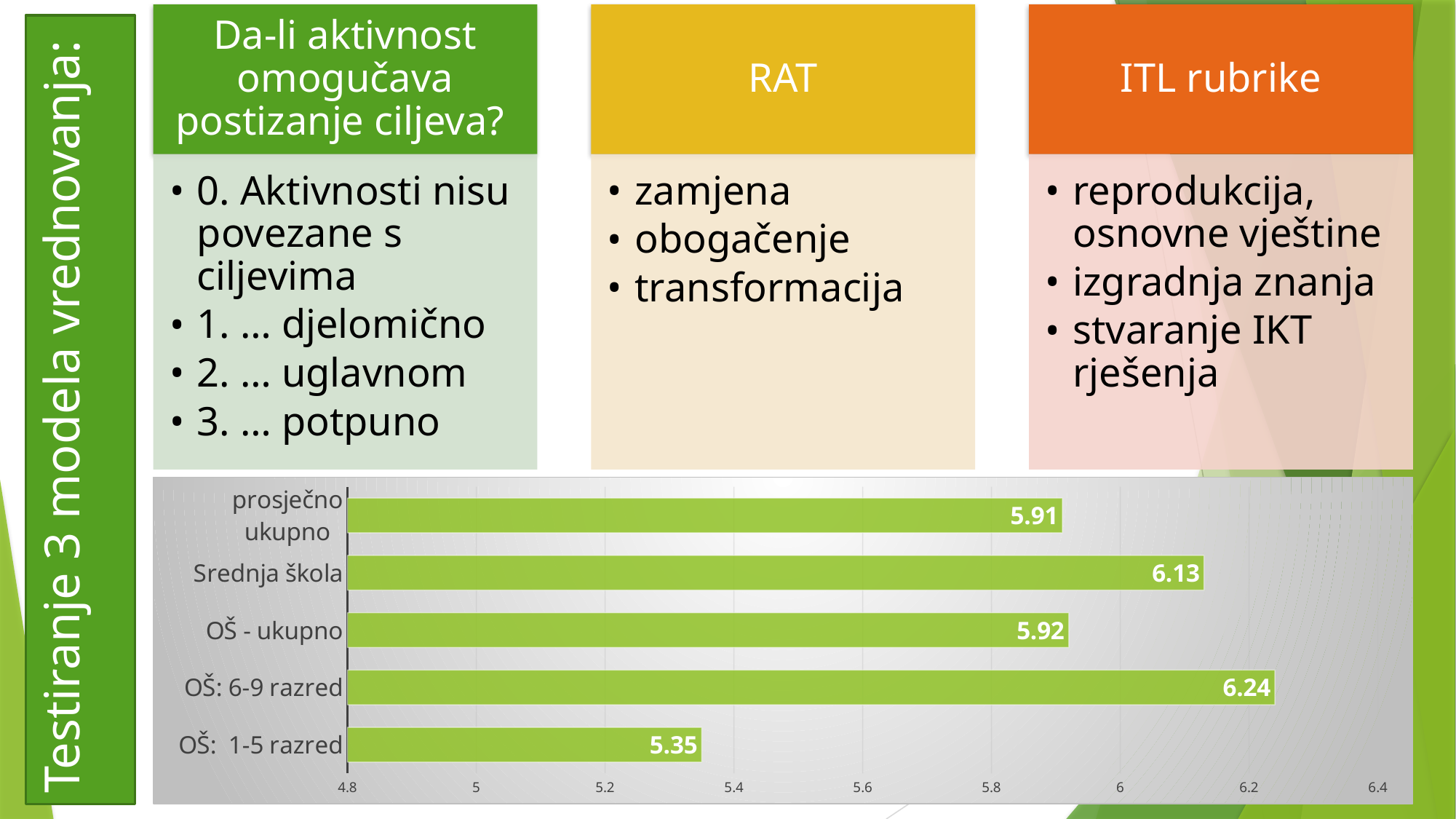
What is the difference between the values for OŠ - ukupno and prosječno ukupno? 0.01 Which category has the lowest value? OŠ: 1-5 razred What kind of chart is shown on the slide? bar chart What is the value for OŠ: 1-5 razred? 5.35 How many categories are shown in the chart? 5 What is the value for prosječno ukupno? 5.91 Which is larger, the value for Srednja škola or the value for OŠ - ukupno? Srednja škola Is the value for OŠ: 1-5 razred greater or less than 5.4? less What is the value for Srednja škola? 6.13 Which category has the highest value? OŠ: 6-9 razred What is the value for OŠ: 6-9 razred? 6.24 What is the difference between the values for OŠ: 6-9 razred and OŠ: 1-5 razred? 0.89